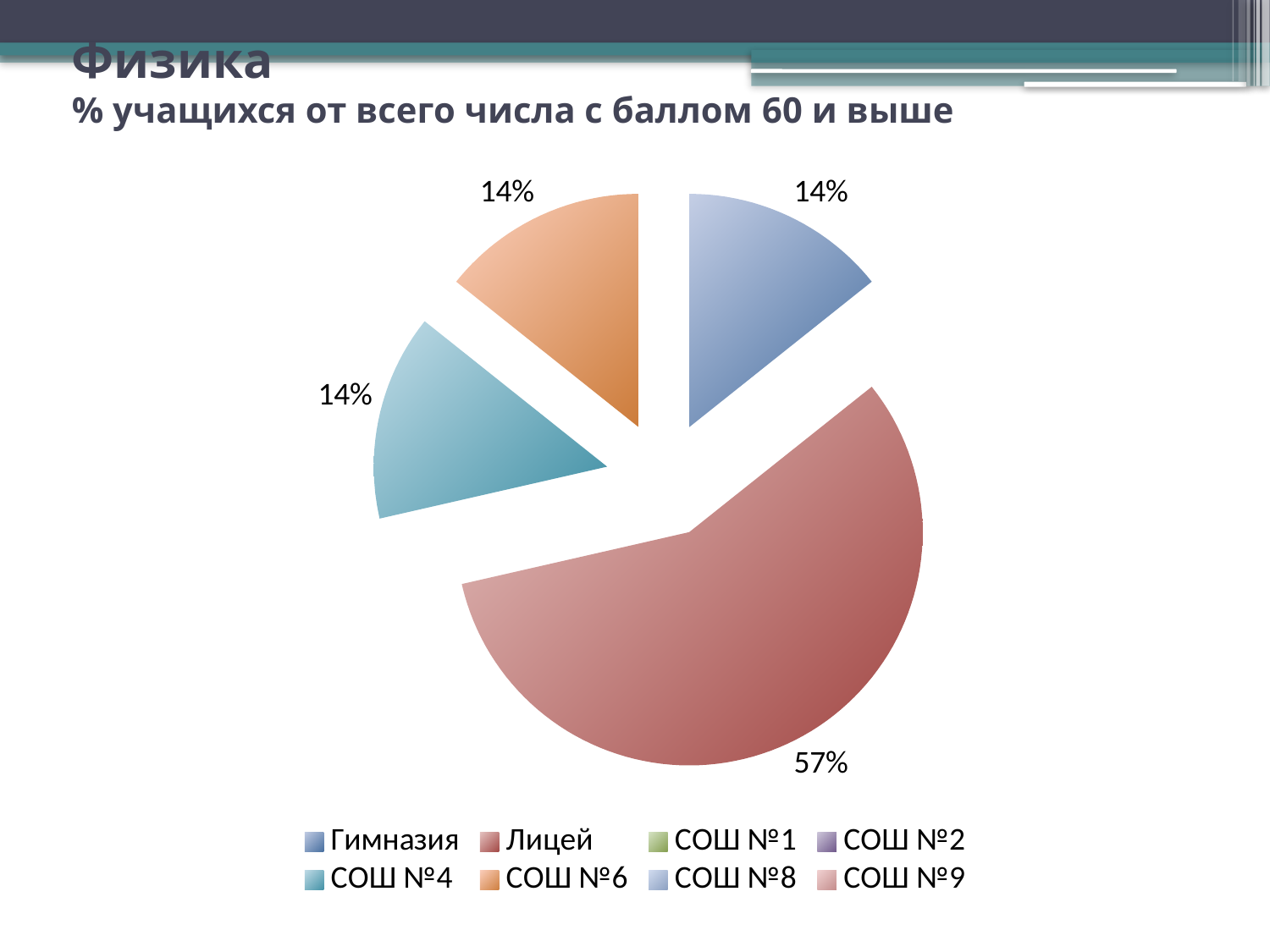
What is the subtitle of the chart below the word Физика? % учащихся от всего числа с баллом 60 и выше What percentage does the СОШ №6 slice show? 14% Which is larger, the slice for Лицей or the slice for Гимназия? Лицей Which category has the largest slice of the pie? Лицей What is the difference in percentage points between the Лицей slice and the СОШ №6 slice? 43 What percentage does the СОШ №4 slice show? 14% What colour is the Лицей slice? red What kind of chart is shown on the slide? pie chart How many entries does the legend list? 8 What percentage does the Гимназия slice show? 14% How many slices with a visible data label are shown in the pie? 4 What percentage does the Лицей slice show? 57%